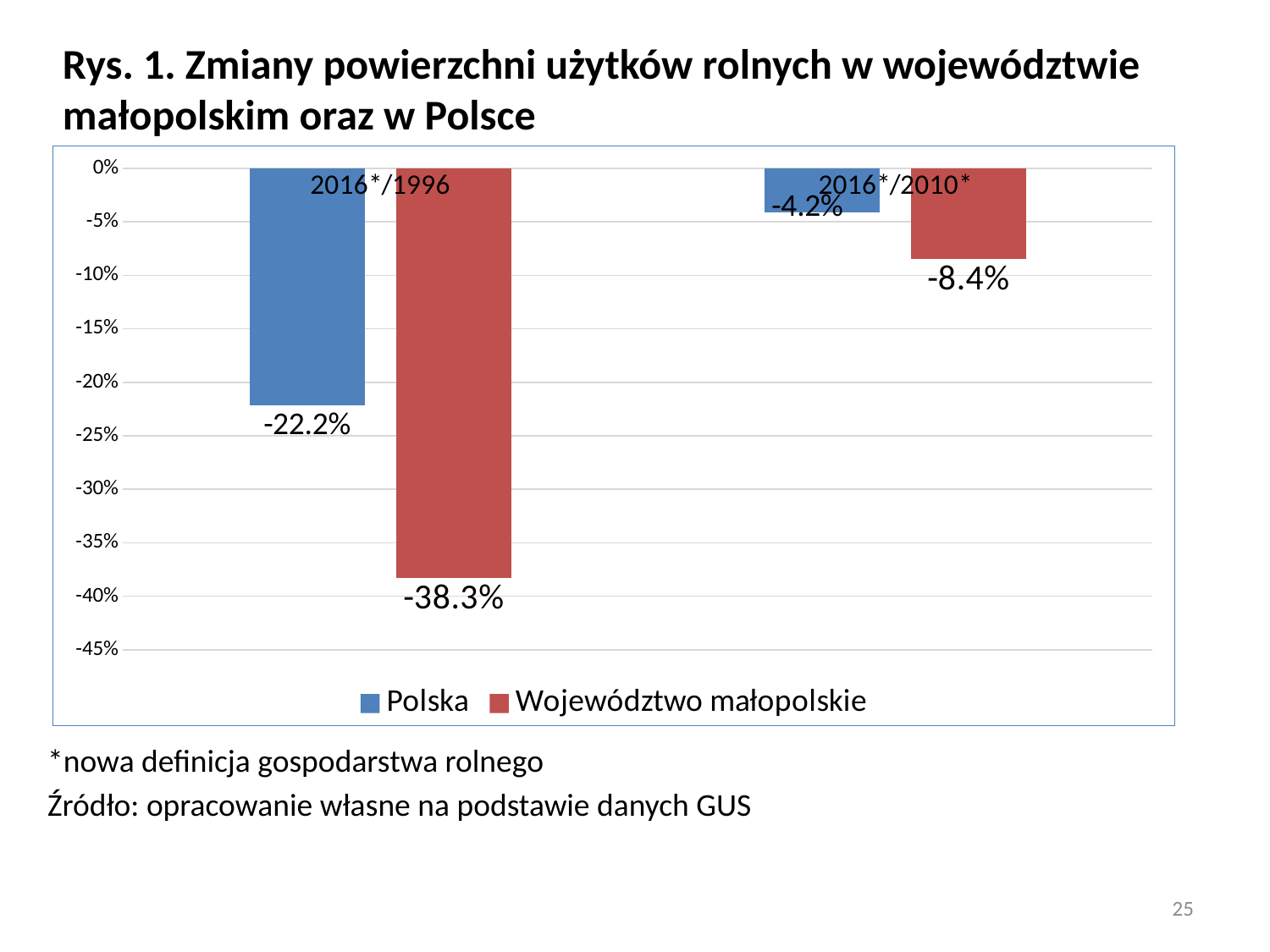
What is the value for Województwo małopolskie in the 2016*/1996 category? -38.3% How many categories are shown on the x axis? 2 Which bar shows the highest value on the chart? Polska, 2016*/2010* In the 2016*/2010* category, which series has the larger decline, Polska or Województwo małopolskie? Województwo małopolskie What is the value for Polska in the 2016*/1996 category? -22.2% What is the value for Polska in the 2016*/2010* category? -4.2% What is the value for Województwo małopolskie in the 2016*/2010* category? -8.4% What is the difference between the Polska and Województwo małopolskie values in the 2016*/2010* category? 4.2 percentage points What is the difference between the Polska and Województwo małopolskie values in the 2016*/1996 category? 16.1 percentage points Which bar shows the lowest value on the chart? Województwo małopolskie, 2016*/1996 What kind of chart is shown on the slide? Bar chart How many series does the legend list? 2